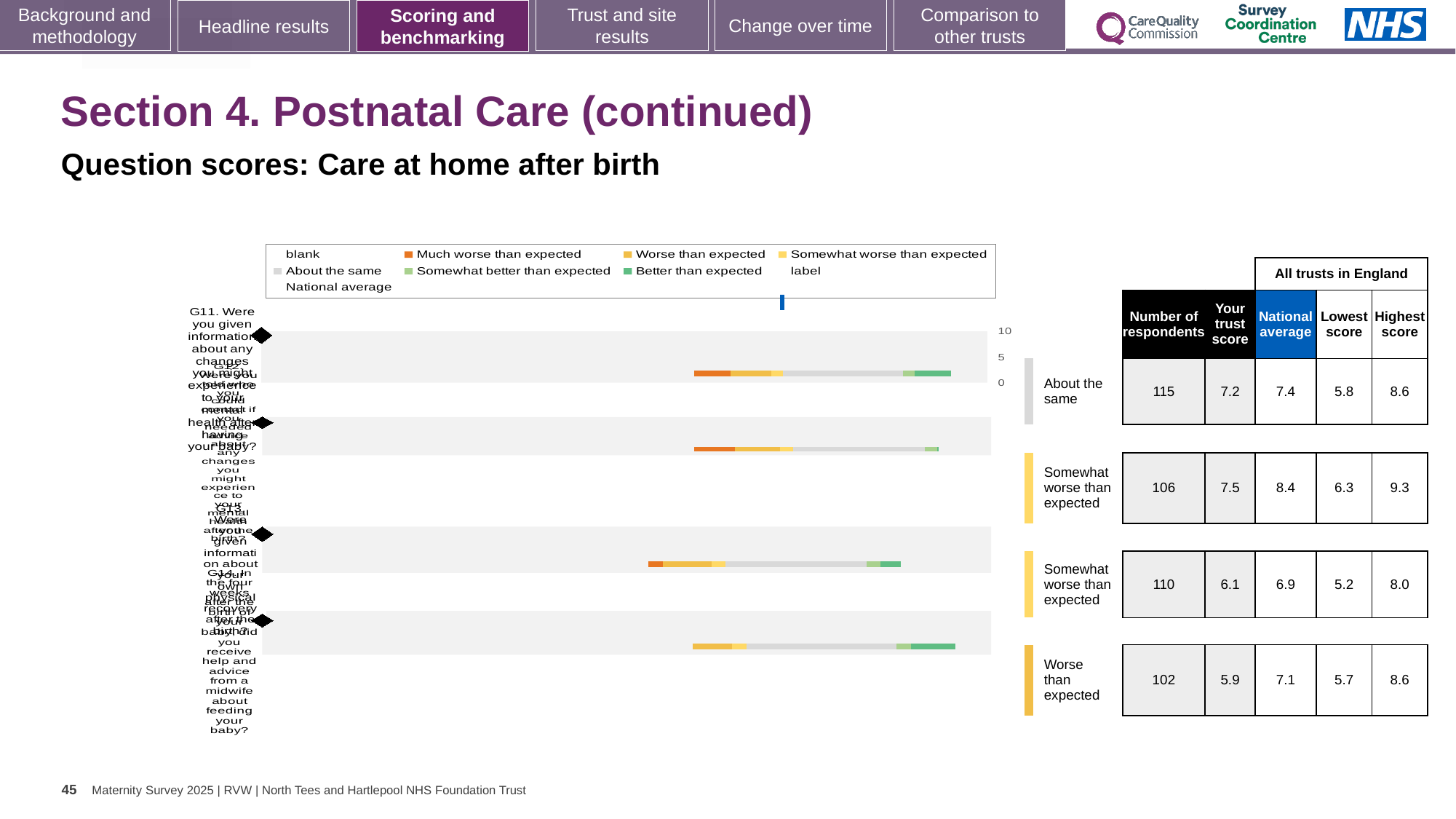
In the table beside the chart, what is the highest score for the second row? 9.3 Which legend entry is shown in orange? Much worse than expected In the table beside the chart, what is the trust score for the first row (About the same)? 7.2 In the table beside the chart, what is the number of respondents for the first row (About the same)? 115 What is the highest value shown on the chart's numeric axis? 10 In the table beside the chart, what is the national average for the last row (Worse than expected)? 7.1 In the table beside the chart, what is the difference between the national average and the trust score for the last row (Worse than expected)? 1.2 In the table beside the chart, which row has the lowest trust score? Worse than expected (last row) In the table beside the chart, what is the lowest score for the third row? 5.2 What kind of chart is shown on the slide? bar chart How many question bars are plotted in the chart? 4 In the table beside the chart, is the trust score for the first row (7.2) larger or smaller than the national average (7.4)? smaller